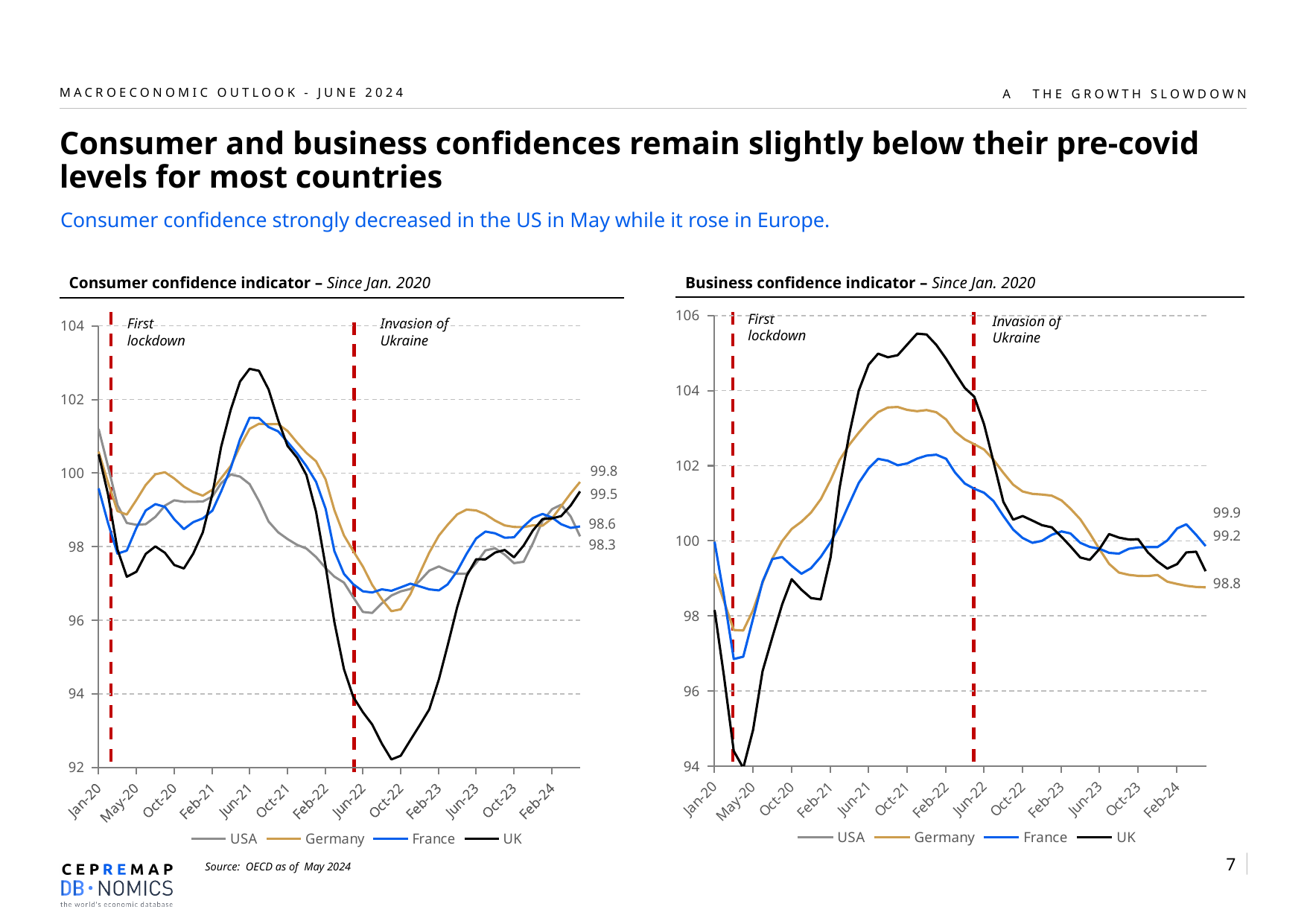
What two events are marked by the red dashed vertical lines on the charts? First lockdown and Invasion of Ukraine In the Consumer confidence indicator chart, which country reaches the highest peak over the period? UK In the Business confidence indicator chart, which country reaches the highest peak over the period? UK In the Consumer confidence indicator chart, what is the latest value shown for Germany? 99.8 In the Business confidence indicator chart, what is the latest value shown for France? 99.9 In the Business confidence indicator chart, which country has the highest latest value? France In the Consumer confidence indicator chart, is the UK value around Oct-22 greater or less than 94? less In the Business confidence indicator chart, is the Germany value around Oct-21 greater or less than 102? greater In the Business confidence indicator chart, what is the latest value shown for Germany? 98.8 In the Business confidence indicator chart, what is the difference between the latest values of France and Germany? 1.1 What kind of chart is the Consumer confidence indicator chart? Line chart How many series does the legend of the Consumer confidence indicator chart list? 4